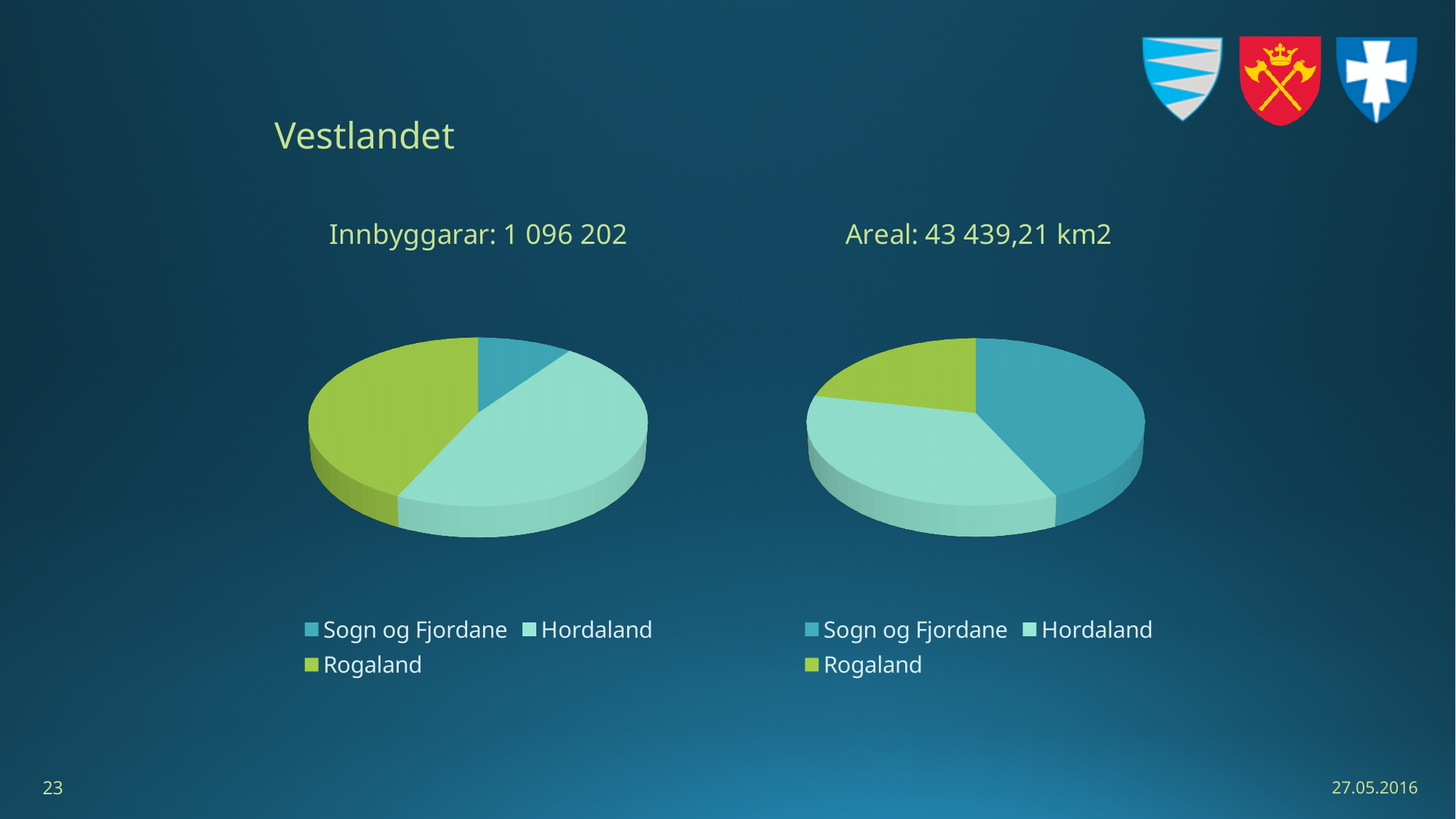
In the chart titled 'Areal: 43 439,21 km2', which slice is larger, Hordaland or Rogaland? Hordaland In the chart titled 'Innbyggarar: 1 096 202', which slice is larger, Rogaland or Sogn og Fjordane? Rogaland What kind of chart is the chart titled 'Innbyggarar: 1 096 202'? pie chart What is the title of the right pie chart on the slide? Areal: 43 439,21 km2 In the chart titled 'Innbyggarar: 1 096 202', which category has the largest slice? Hordaland In the chart titled 'Areal: 43 439,21 km2', which slice is larger, Sogn og Fjordane or Rogaland? Sogn og Fjordane In the chart titled 'Innbyggarar: 1 096 202', which category has the smallest slice? Sogn og Fjordane In the chart titled 'Areal: 43 439,21 km2', how many categories does the legend list? 3 In the chart titled 'Innbyggarar: 1 096 202', how many slices does the pie have? 3 In the chart titled 'Areal: 43 439,21 km2', which category has the smallest slice? Rogaland What kind of chart is the chart titled 'Areal: 43 439,21 km2'? pie chart What is the title of the left pie chart on the slide? Innbyggarar: 1 096 202